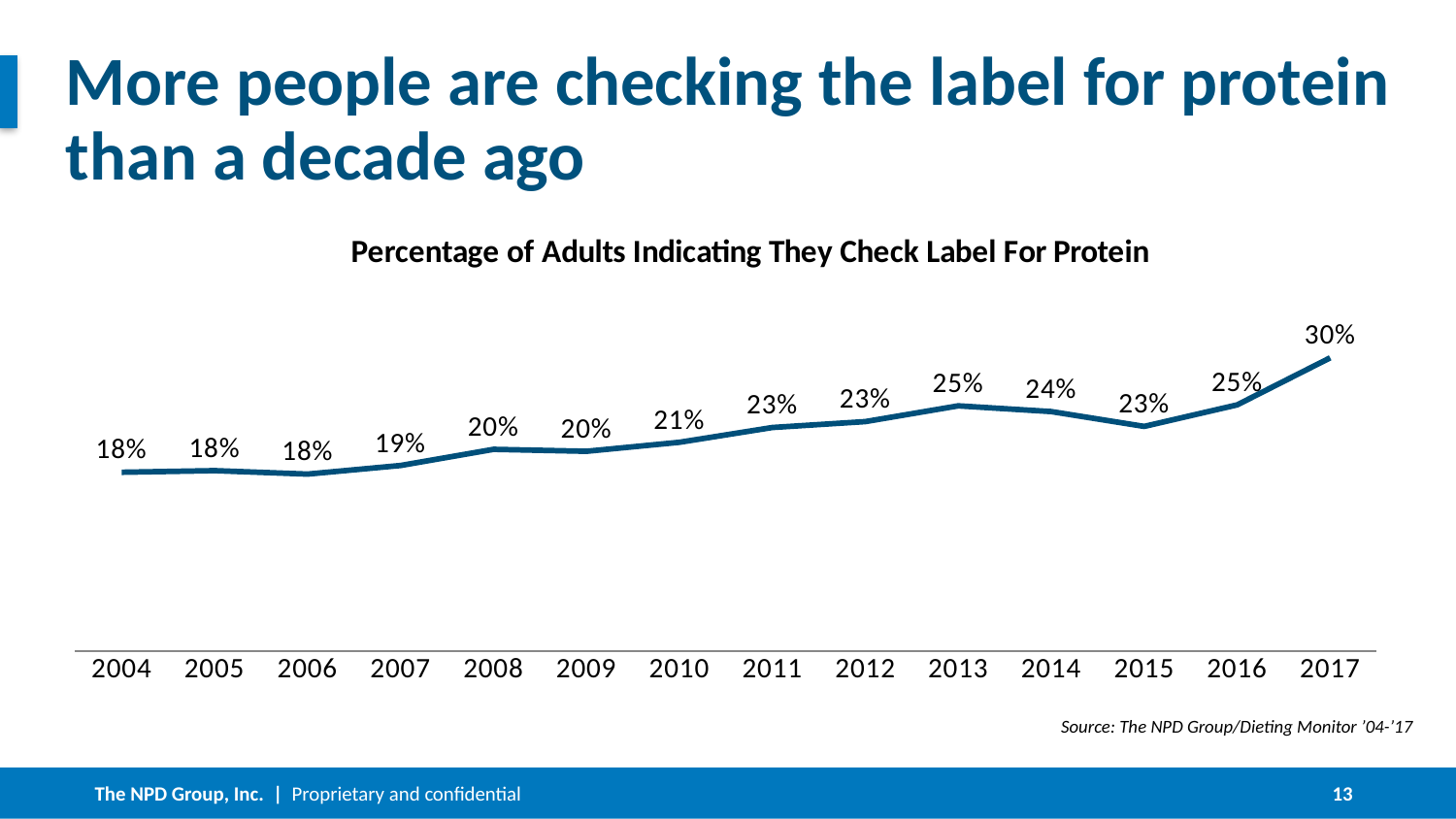
How many years are plotted on the chart? 14 What is the difference between the 2013 value and the 2015 value? 2% Which year has the highest percentage of adults checking the label for protein? 2017 Which is larger, the value for 2016 or the value for 2015? 2016 What is the title of the chart? Percentage of Adults Indicating They Check Label For Protein What is the value shown for 2013? 25% What is the difference between the 2017 value and the 2004 value? 12% What percentage of adults indicated they check the label for protein in 2017? 30% What is the value shown for 2010? 21% What kind of chart is shown on the slide? Line chart Do the values generally rise or fall from 2004 to 2017? Rise What is the value shown for 2004? 18%